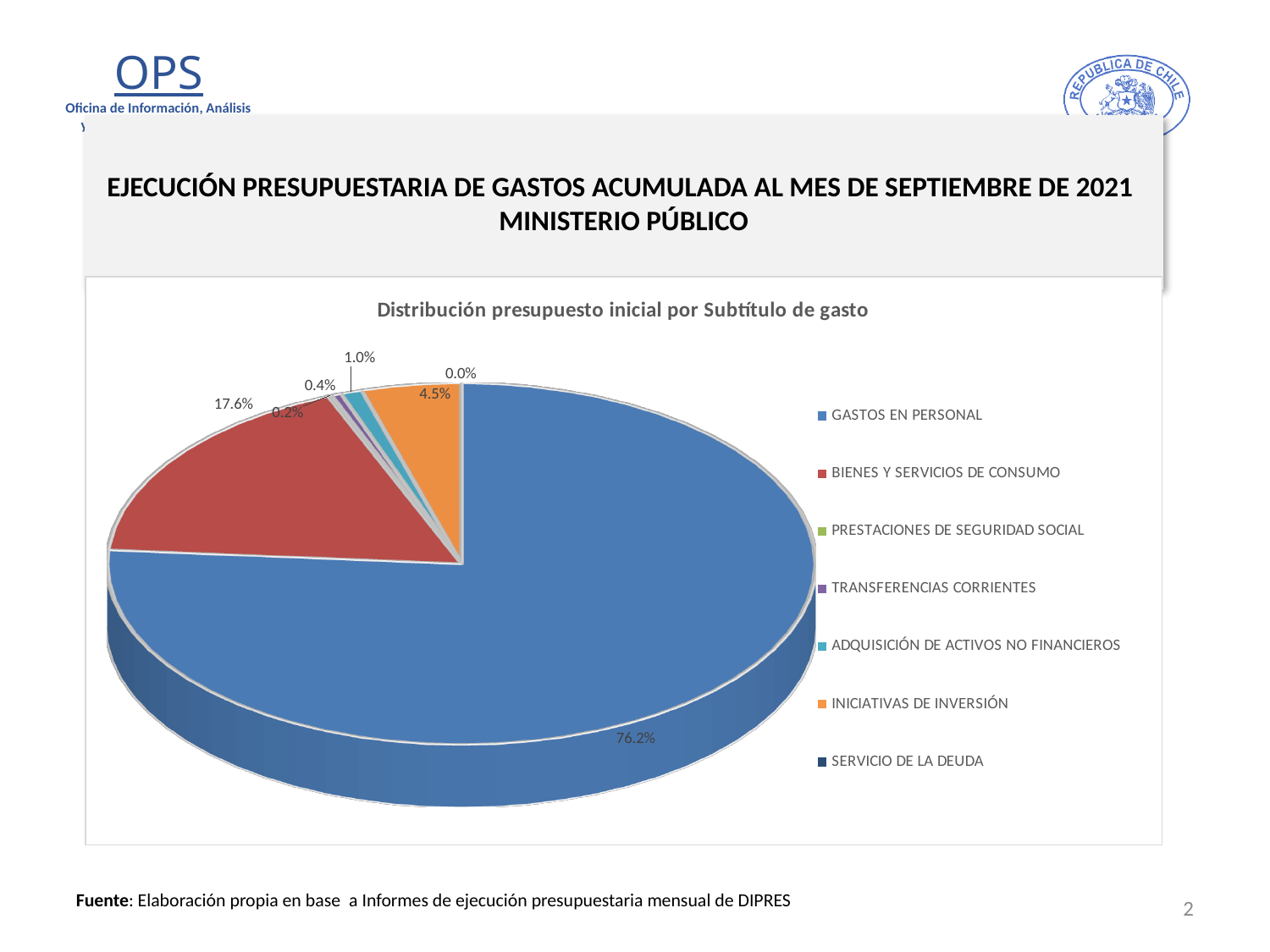
Which category has the smallest share of the pie? SERVICIO DE LA DEUDA What share of the pie does INICIATIVAS DE INVERSIÓN represent? 4.5% What is the difference in percentage points between the share for GASTOS EN PERSONAL and the share for BIENES Y SERVICIOS DE CONSUMO? 58.6 What share of the pie does BIENES Y SERVICIOS DE CONSUMO represent? 17.6% What colour is the slice for GASTOS EN PERSONAL? blue What share of the pie does GASTOS EN PERSONAL represent? 76.2% How many categories does the chart's legend list? 7 What is the title of the chart? Distribución presupuesto inicial por Subtítulo de gasto What type of chart is shown on the slide? pie chart Which is larger, the share for BIENES Y SERVICIOS DE CONSUMO or the share for INICIATIVAS DE INVERSIÓN? BIENES Y SERVICIOS DE CONSUMO What share of the pie does SERVICIO DE LA DEUDA represent? 0.0% Which category has the largest share of the pie? GASTOS EN PERSONAL